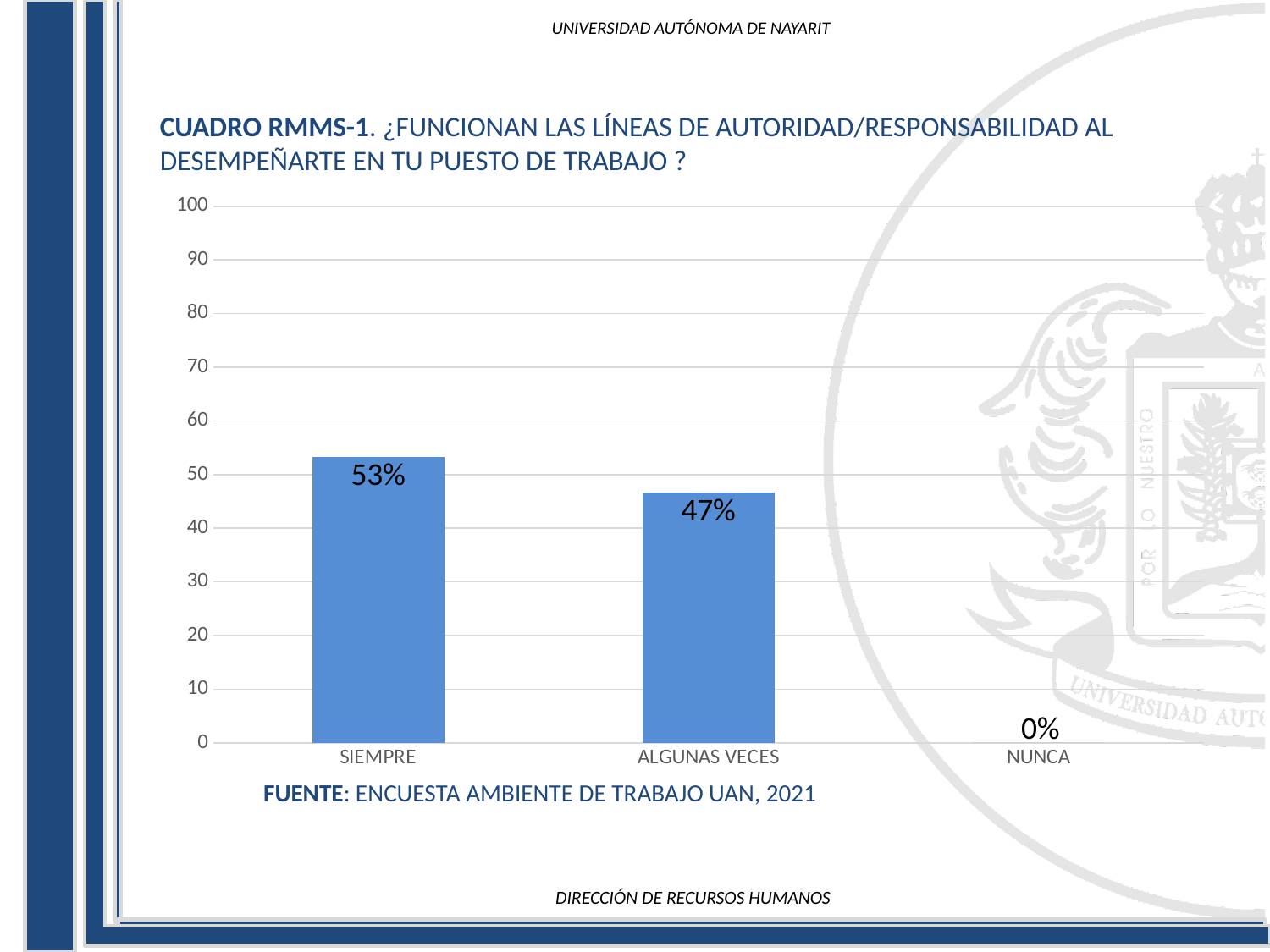
Which is larger, the value for SIEMPRE or the value for ALGUNAS VECES? SIEMPRE What is the value for NUNCA? 0% Is the value for ALGUNAS VECES greater or less than 50? less What is the difference between the values for SIEMPRE and ALGUNAS VECES? 6% What kind of chart is shown on the slide? bar chart How many categories are shown on the x axis? 3 What is the value for SIEMPRE? 53% Do the values rise or fall from left to right along the x axis? fall What source is cited below the chart? ENCUESTA AMBIENTE DE TRABAJO UAN, 2021 Which category has the lowest value? NUNCA Which category has the highest value? SIEMPRE What is the value for ALGUNAS VECES? 47%